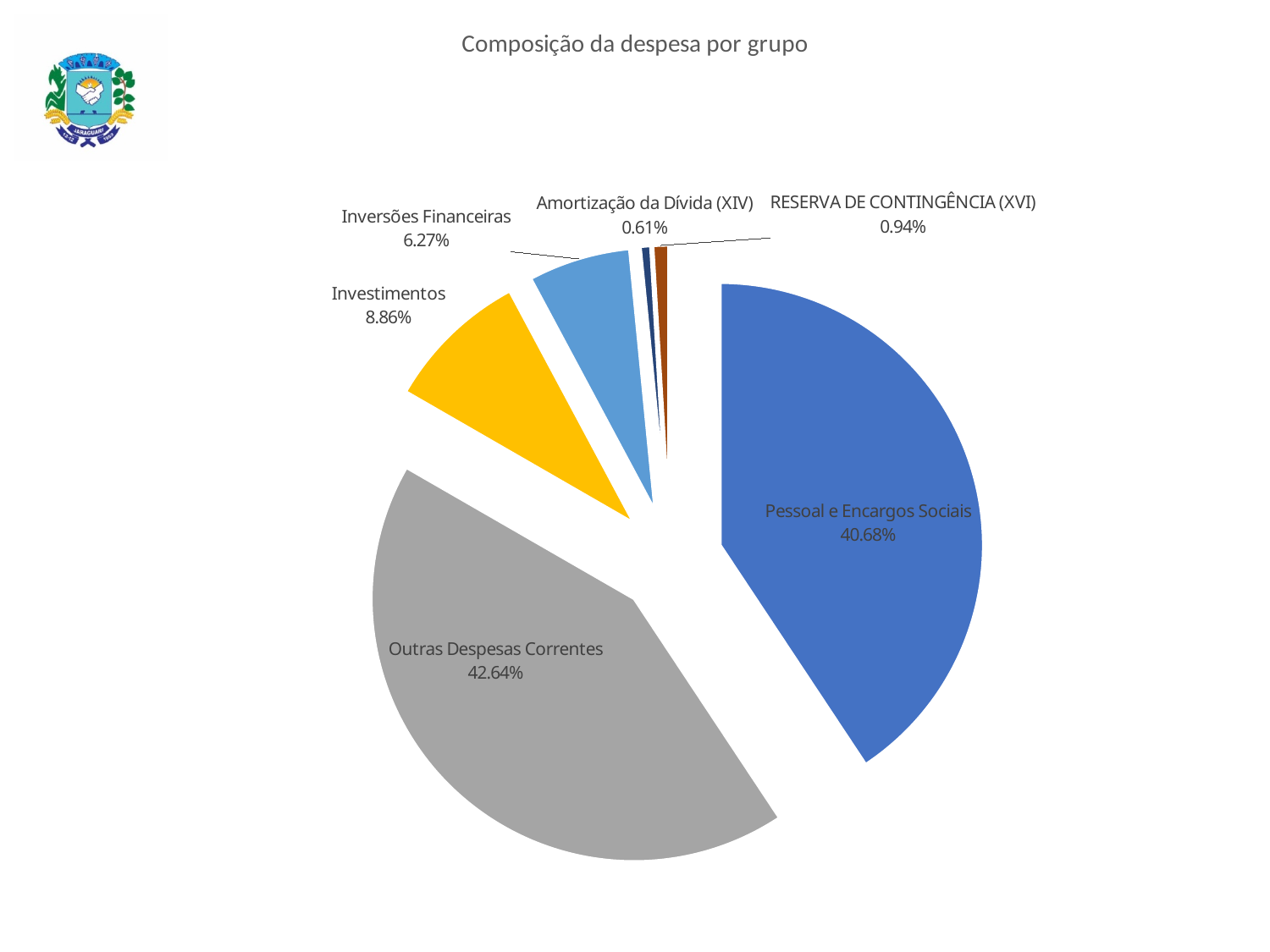
What is the value shown for Amortização da Dívida (XIV)? 0.61% How many slices does the pie chart have? 6 Which category has the largest slice of the pie? Outras Despesas Correntes What is the difference between the shares of Outras Despesas Correntes and Pessoal e Encargos Sociais? 1.96% What is the title of the chart? Composição da despesa por grupo What share of the pie does Outras Despesas Correntes represent? 42.64% Which category has the smallest slice of the pie? Amortização da Dívida (XIV) What type of chart is shown on the slide? Pie chart What is the value shown for Inversões Financeiras? 6.27% What is the value shown for Investimentos? 8.86% What is the value shown for RESERVA DE CONTINGÊNCIA (XVI)? 0.94% What share of the pie does Pessoal e Encargos Sociais represent? 40.68%